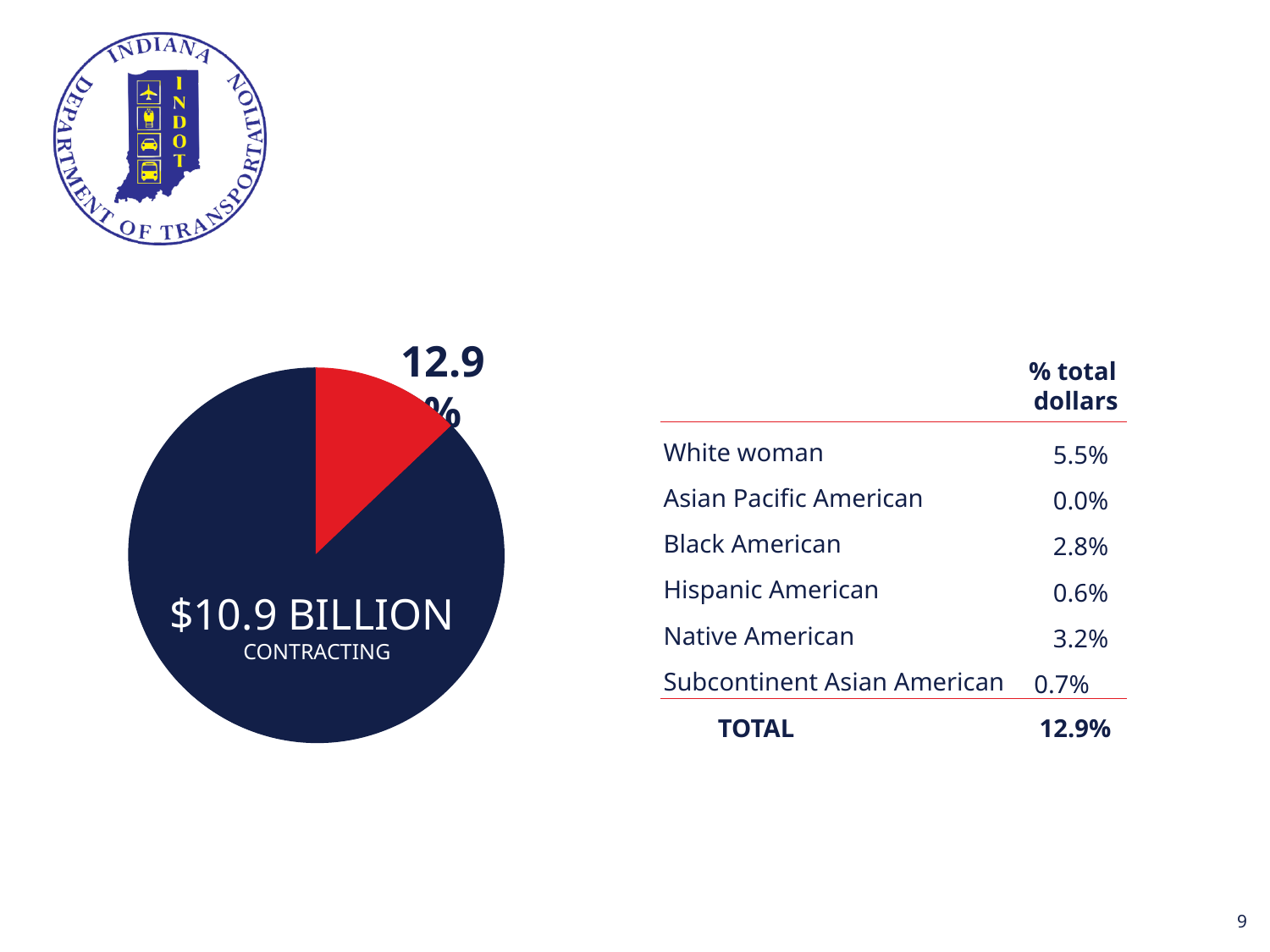
In the table next to the pie chart, what is the difference between the % total dollars for Native American and Black American? 0.4% Which slice of the pie chart is larger, the red slice or the dark blue slice? the dark blue slice What dollar amount is printed in the center of the pie chart? $10.9 BILLION In the table next to the pie chart, which category has the lowest % total dollars? Asian Pacific American What kind of chart is shown on the slide? pie chart What percentage does the red slice of the pie chart represent? 12.9% In the table next to the pie chart, what is the % total dollars for White woman? 5.5% In the table next to the pie chart, which category has the highest % total dollars? White woman Is the share of the red slice in the pie chart greater or less than 50%? less How many slices does the pie chart have? 2 What word appears below the dollar amount in the center of the pie chart? CONTRACTING In the table next to the pie chart, what is the TOTAL % total dollars? 12.9%